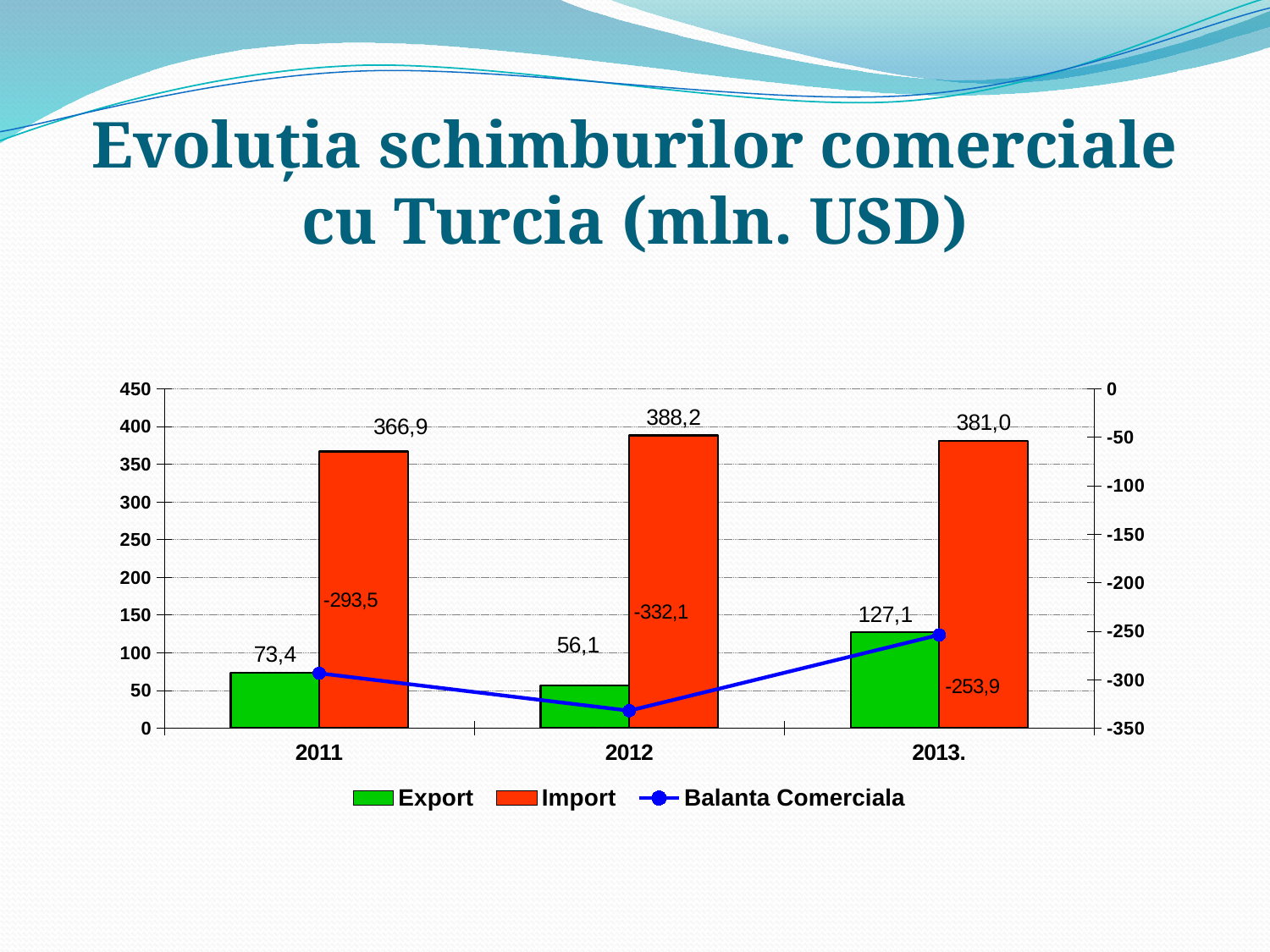
How many years are shown on the x axis? 3 What is the Import value for 2012? 388,2 What is the Import value for 2013? 381,0 In which year is the Export value highest? 2013 What is the Export value for 2011? 73,4 In which year is the Export value lowest? 2012 Which is larger, the Export value for 2011 or the Export value for 2012? 2011 How many series does the legend list? 3 What is the difference between the Export values for 2013 and 2012? 71,0 What is the Balanta Comerciala value for 2013? -253,9 In which year is the Import value highest? 2012 What is the difference between the Import values for 2012 and 2011? 21,3